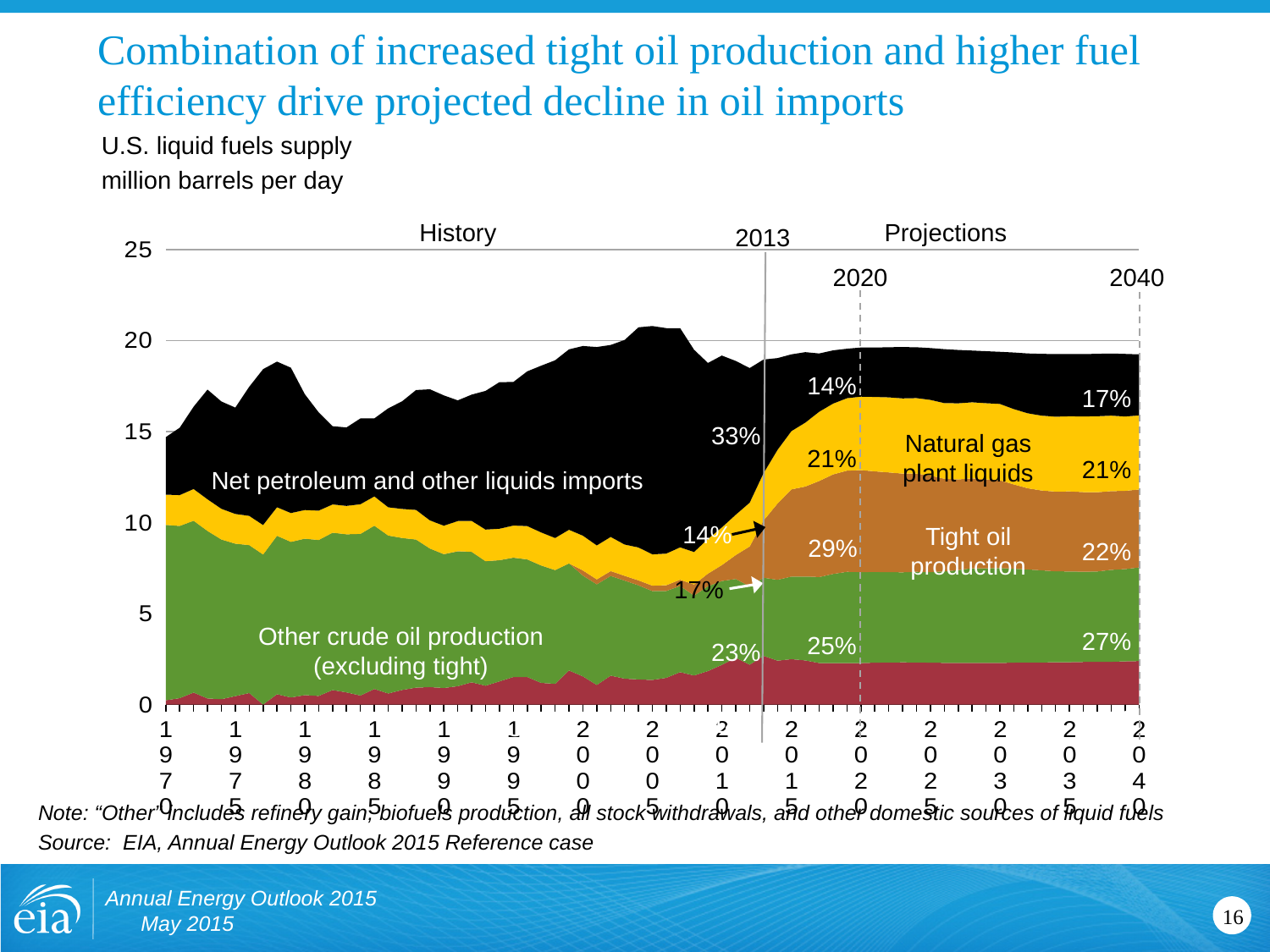
What share of supply is projected for net petroleum and other liquids imports in 2040? 17% What share of supply is projected for other crude oil production (excluding tight) in 2040? 27% What share of U.S. liquid fuels supply did net petroleum and other liquids imports account for in 2013? 33% What share of supply is projected for tight oil production in 2020? 29% Is total U.S. liquid fuels supply in 2013 greater or less than 15 million barrels per day? greater By how many percentage points does the share of net petroleum and other liquids imports fall from 2013 to 2020? 19 percentage points What kind of chart is shown on the slide? Stacked area chart Does the share of net petroleum and other liquids imports rise or fall between 2013 and 2020? fall Is the projected share of tight oil production larger in 2020 or in 2040? 2020 What share of supply is projected for natural gas plant liquids in 2040? 21% What is the title of the chart? U.S. liquid fuels supply In what units is the y axis of the chart measured? million barrels per day